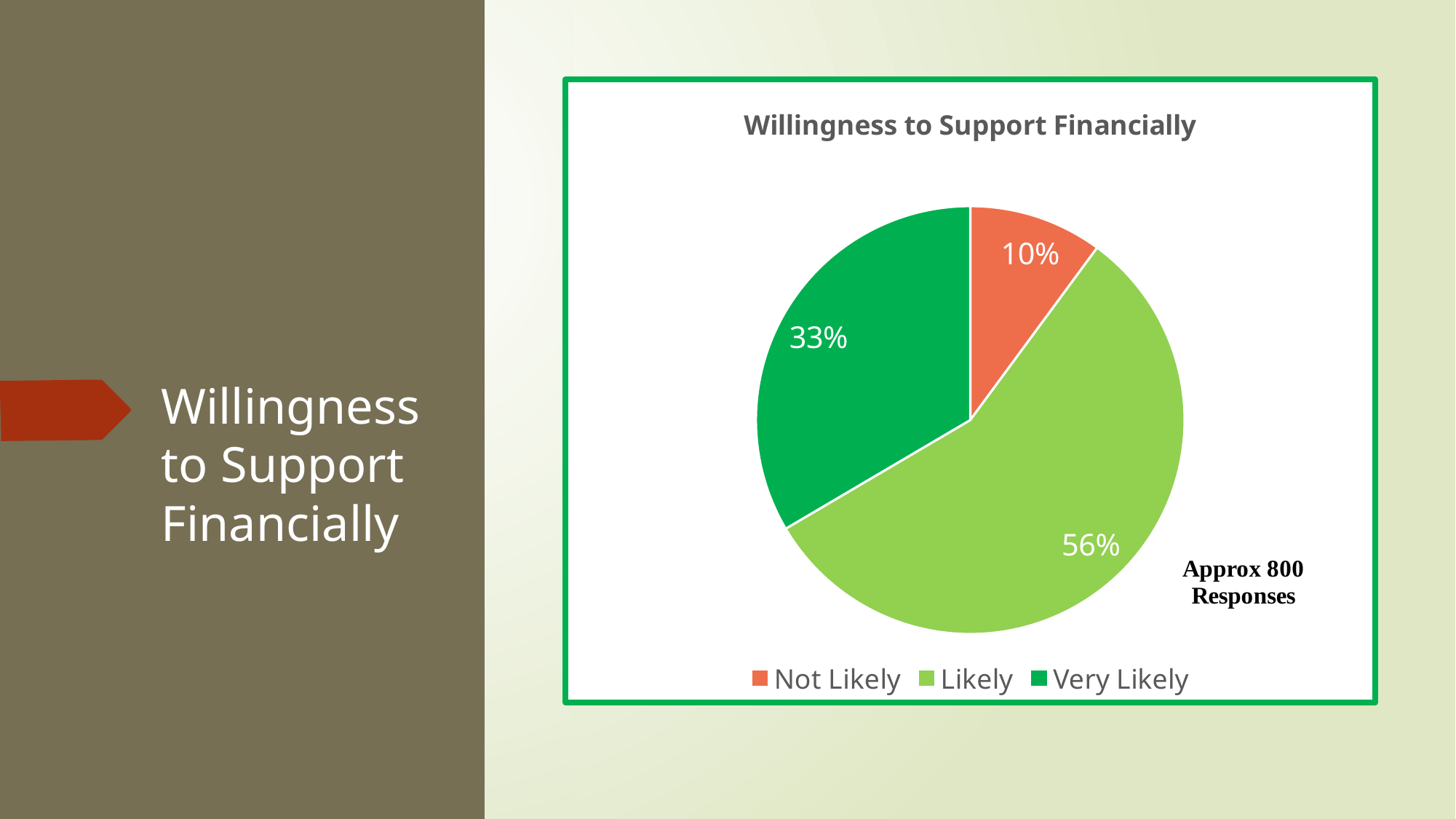
What percentage of the pie is labelled "Not Likely"? 10% Approximately how many responses does the chart note say it is based on? Approx 800 Responses What kind of chart is shown on the slide? pie chart What percentage of the pie is labelled "Likely"? 56% Which category has the smallest share of the pie? Not Likely How many categories does the pie chart show? 3 Which slice is larger, "Very Likely" or "Not Likely"? Very Likely What is the difference in percentage points between the "Likely" and "Very Likely" slices? 23 How many entries does the legend list? 3 What is the title of the chart? Willingness to Support Financially What percentage of the pie is labelled "Very Likely"? 33% Which category has the largest share of the pie? Likely